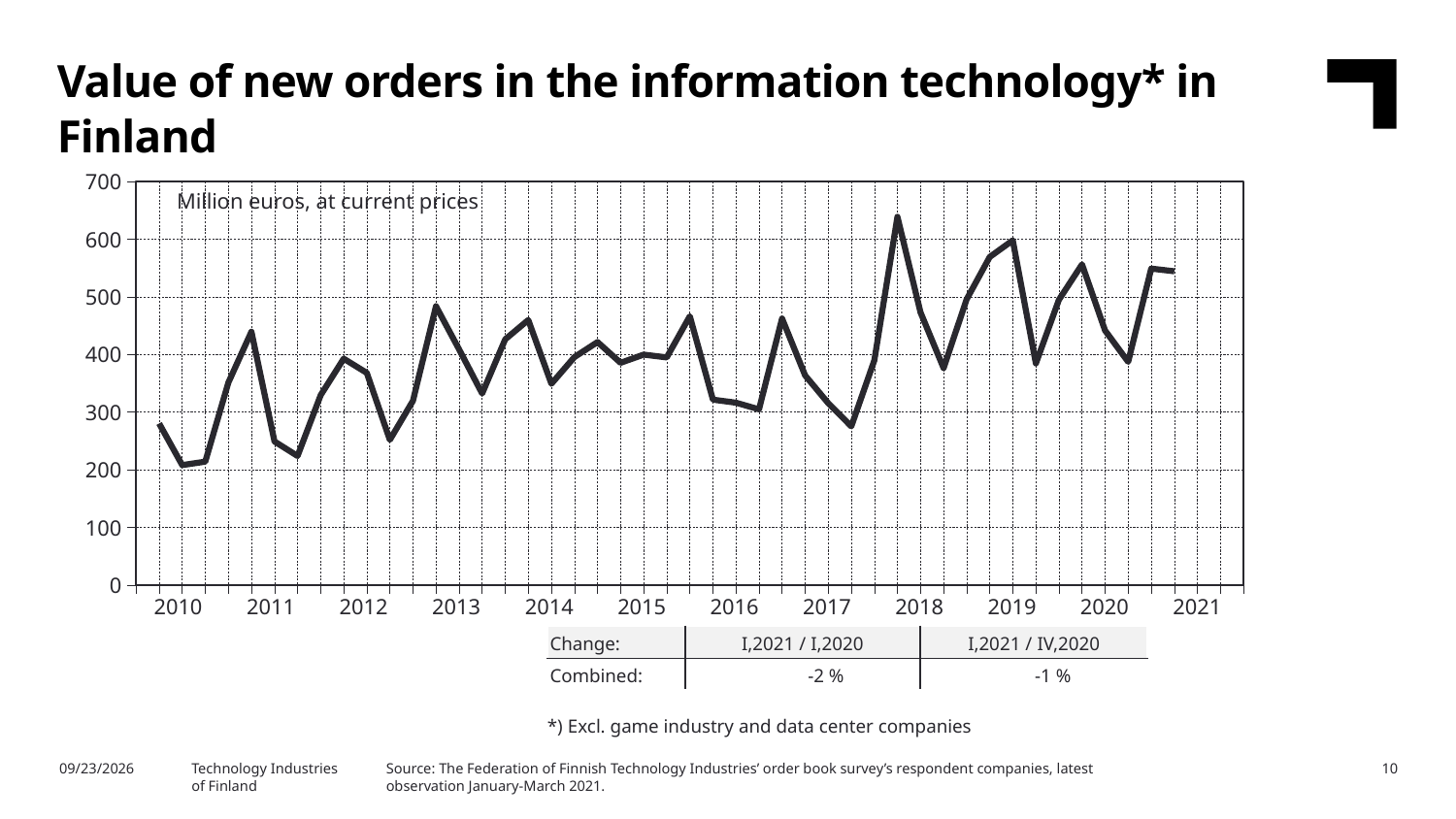
In which year does the line reach its lowest value? 2010 What is the combined change for I,2021 / IV,2020 shown in the table below the chart? -1 % Is the highest value on the chart greater or less than 600? greater What kind of chart is shown on the slide? line chart In which year does the line reach its highest value? 2018 What is the title of the chart? Value of new orders in the information technology* in Finland Is the peak value in 2013 greater or less than 400? greater How many data series are plotted on the chart? 1 In what unit are the values on the chart expressed? Million euros, at current prices What is the combined change for I,2021 / I,2020 shown in the table below the chart? -2 % Is the lowest value on the chart greater or less than 300? less